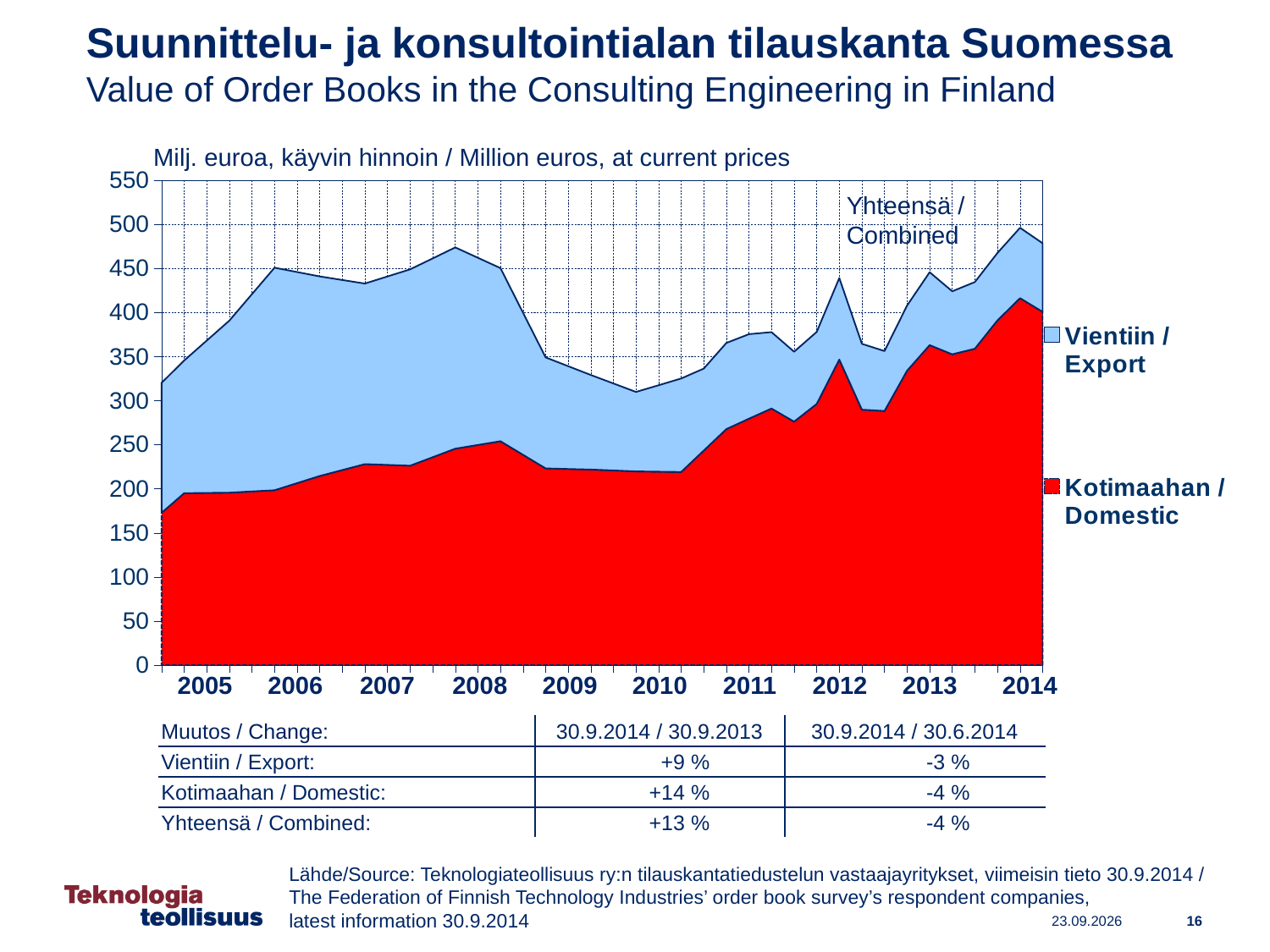
Is the Kotimaahan / Domestic value at the start of 2005 greater or less than 200? less How many years are labelled on the x axis of the chart? 10 In 2014, which is larger: the Kotimaahan / Domestic value or the Vientiin / Export value? Kotimaahan / Domestic How many series does the chart legend list? 2 In which year does the Kotimaahan / Domestic series reach its highest value? 2014 What kind of chart is shown on the slide? stacked area chart Is the Yhteensä / Combined value at the end of 2014 greater or less than 450? greater Does the Kotimaahan / Domestic value rise or fall from 2010 to 2014? rise According to the table below the chart, what is the change for Kotimaahan / Domestic between 30.9.2013 and 30.9.2014? +14 % Is the Yhteensä / Combined value in 2010 greater or less than 350? less Which series is shown in red in the chart? Kotimaahan / Domestic What unit is stated above the chart? Milj. euroa, käyvin hinnoin / Million euros, at current prices